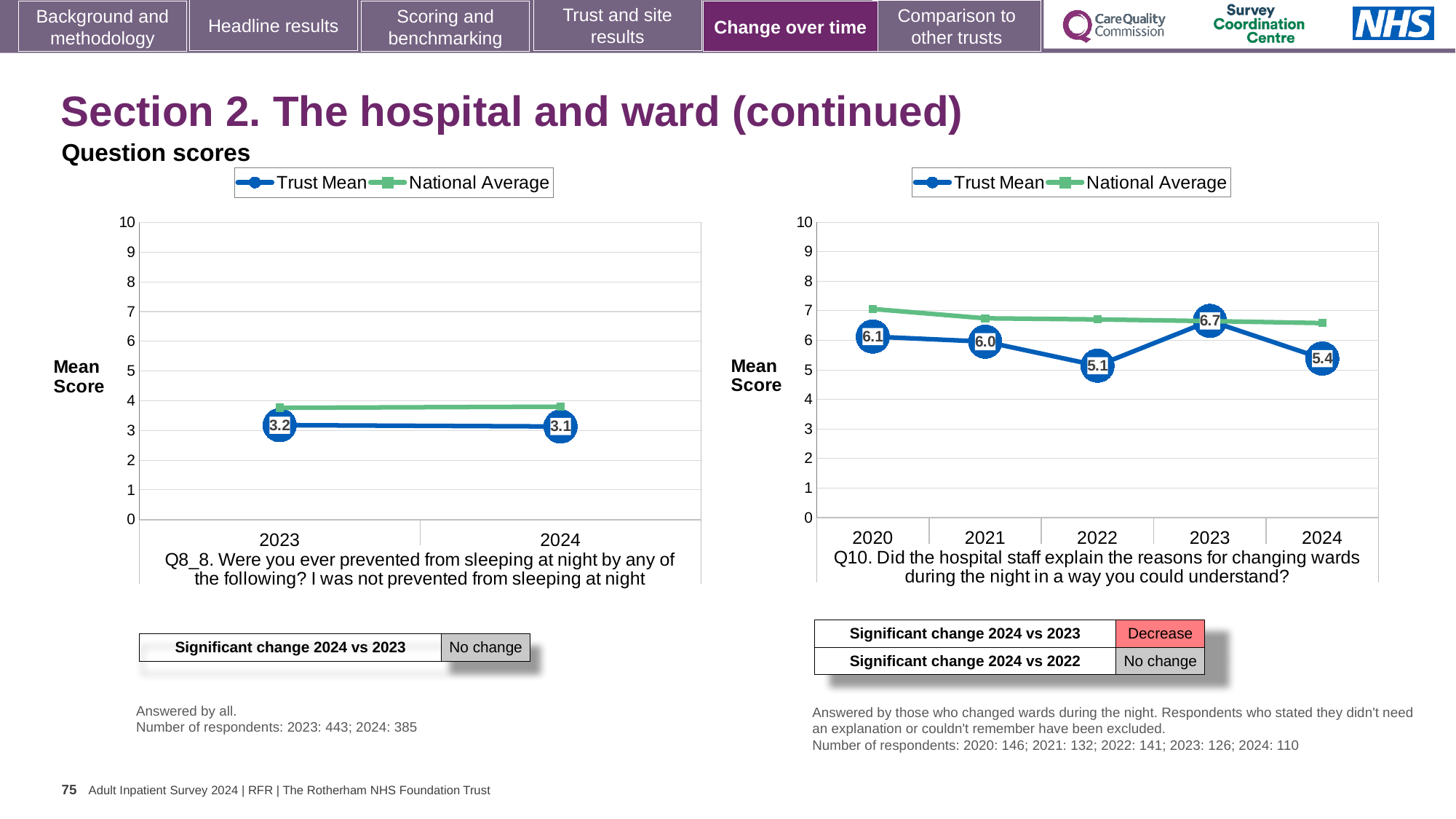
In the Q8_8 chart on the left, what is the Trust Mean score for 2024? 3.1 In the Q10 chart on the right, which year has the lowest Trust Mean score? 2022 In the Q8_8 chart on the left, is the National Average for 2024 greater or less than 4? less What kind of chart is the Q8_8 chart on the left? Line chart In the Q8_8 chart on the left, what is the Trust Mean score for 2023? 3.2 In the Q10 chart on the right, what is the difference between the Trust Mean scores for 2023 and 2024? 1.3 In the Q8_8 chart on the left, how many series does the legend list? 2 In the Q10 chart on the right, what is the Trust Mean score for 2022? 5.1 In the Q10 chart on the right, what is the Trust Mean score for 2024? 5.4 In the Q10 chart on the right, which year has the highest Trust Mean score? 2023 In the Q10 chart on the right, how many years are plotted on the x axis? 5